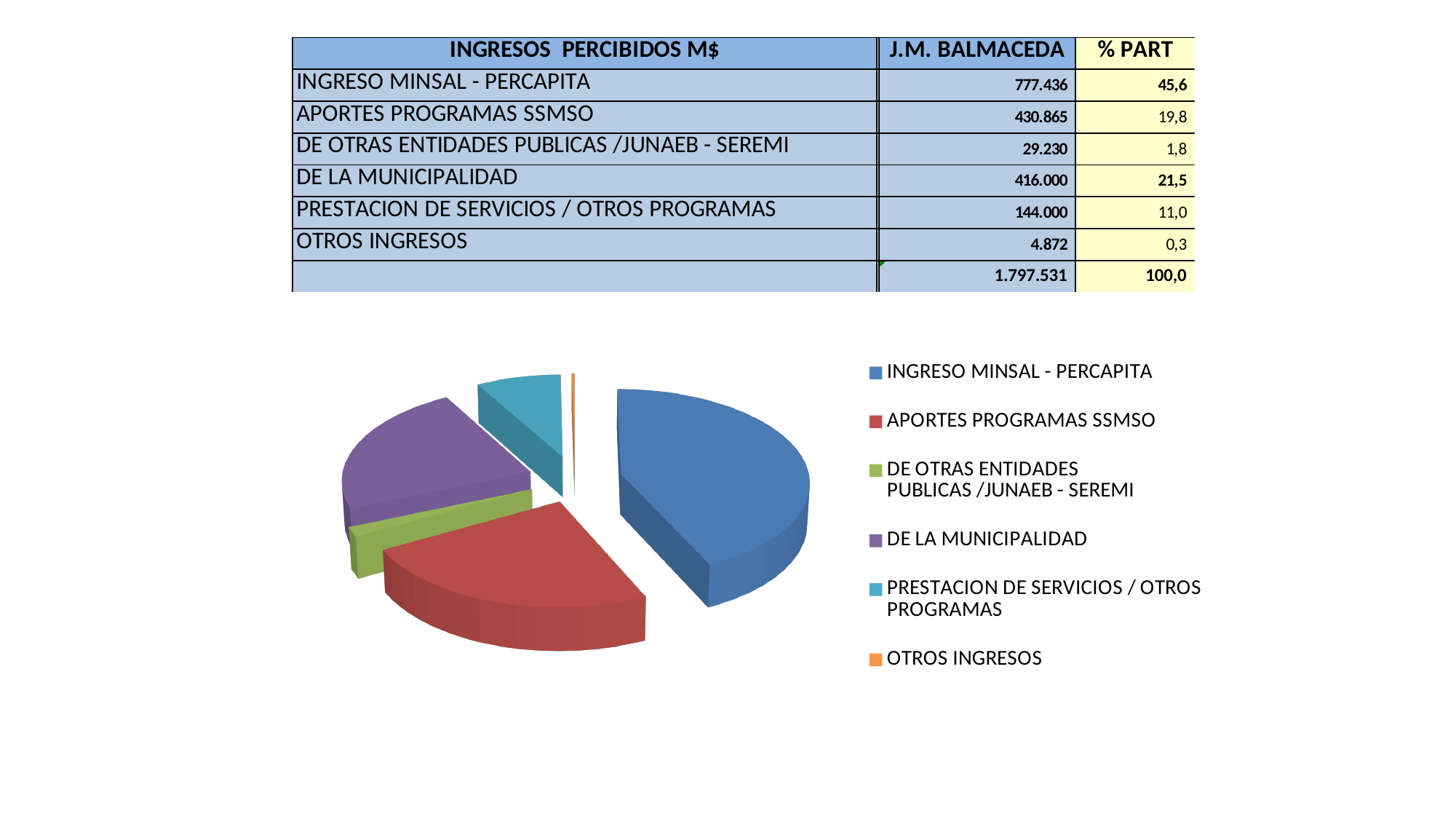
Which category has the largest slice of the pie chart? INGRESO MINSAL - PERCAPITA Which is larger in the pie chart: the slice for APORTES PROGRAMAS SSMSO or the slice for DE OTRAS ENTIDADES PUBLICAS /JUNAEB - SEREMI? APORTES PROGRAMAS SSMSO According to the table, what is the J.M. BALMACEDA value for DE LA MUNICIPALIDAD? 416.000 According to the table, what is the J.M. BALMACEDA value for INGRESO MINSAL - PERCAPITA? 777.436 How many slices does the pie chart have? 6 What percentage share (% PART) does APORTES PROGRAMAS SSMSO have? 19,8 What colour is the slice for DE LA MUNICIPALIDAD in the pie chart? purple What kind of chart is shown on the slide? pie chart Which category has the smallest slice of the pie chart? OTROS INGRESOS What percentage share (% PART) does PRESTACION DE SERVICIOS / OTROS PROGRAMAS have? 11,0 What is the total of all the income categories shown in the table? 1.797.531 How many entries does the pie chart's legend list? 6